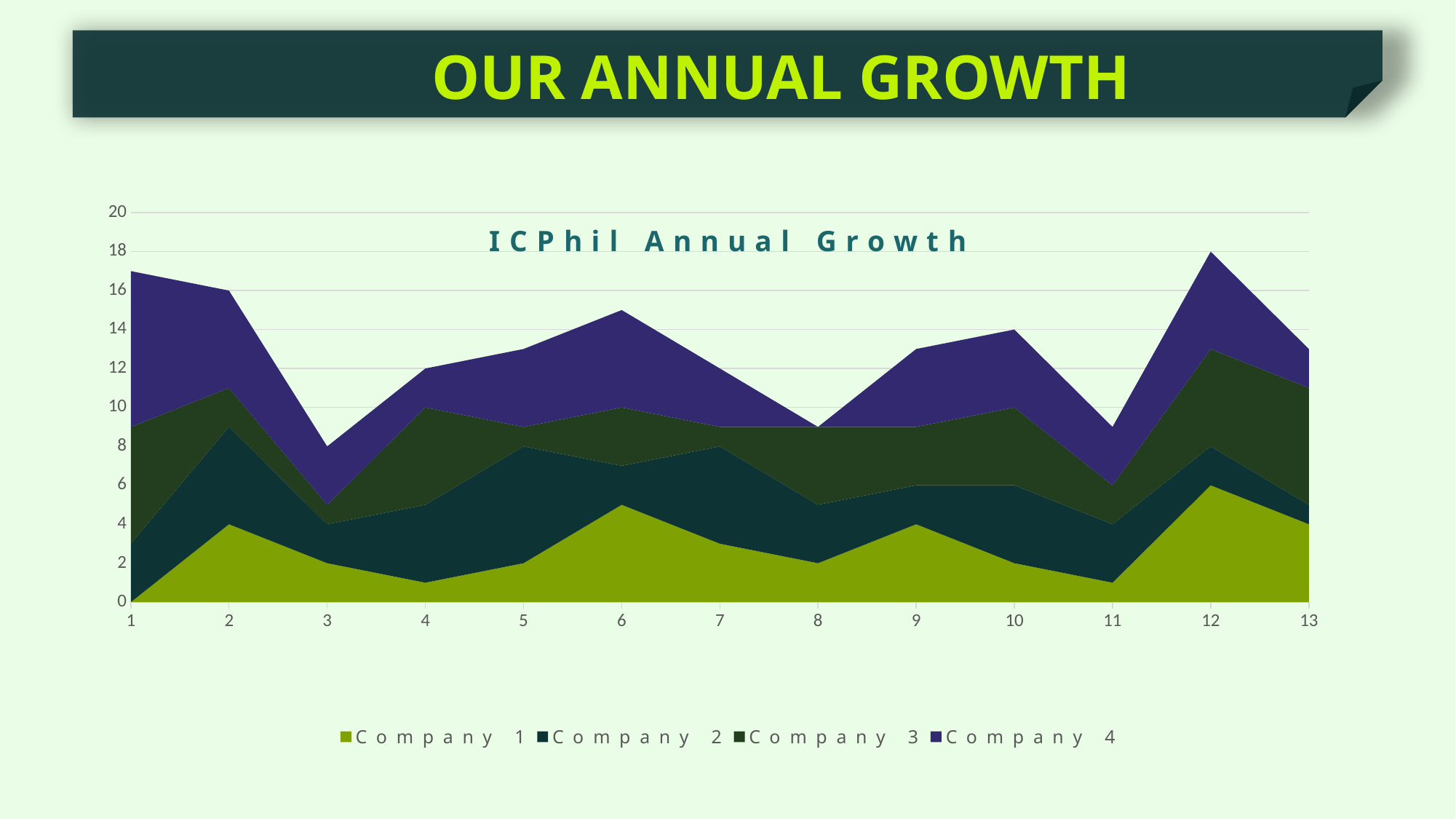
How many points are plotted along the x axis of the chart? 13 Is the total stacked value at point 12 greater or less than 16? greater At which x-axis point is the value for Company 1 highest? 12 What is the title printed inside the chart area? ICPhil Annual Growth What kind of chart is shown on the slide? Stacked area chart At which x-axis point is the value for Company 1 lowest? 1 Is the value for Company 1 at point 12 greater or less than 4? greater How many series does the chart's legend list? 4 What is the value for Company 1 at point 1? 0 Which series is shown in purple in the chart? Company 4 Does the total stacked value rise or fall from point 1 to point 3? fall Is the total stacked value at point 3 greater or less than 10? less